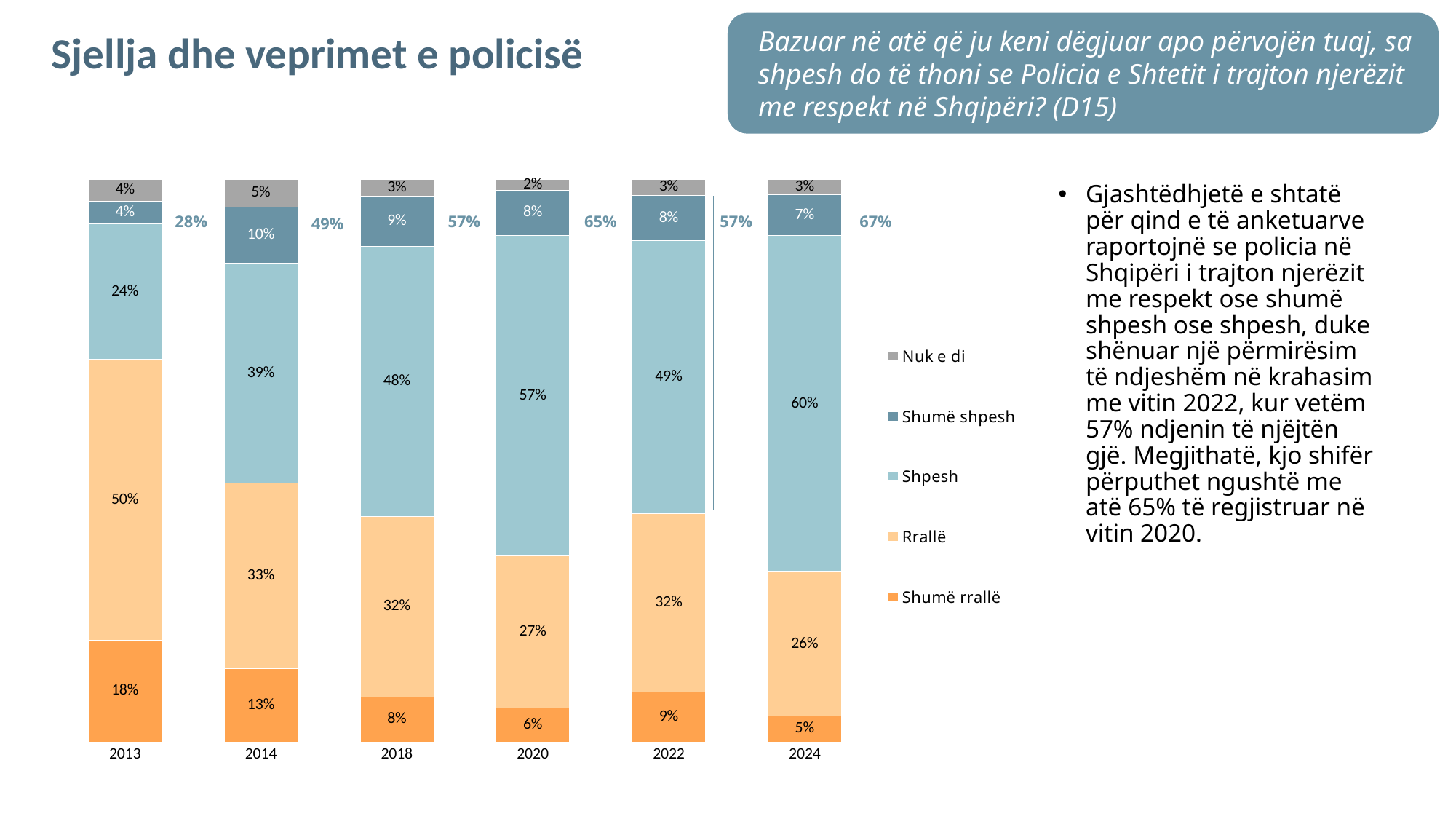
In which year is the 'Shumë rrallë' value lowest? 2024 What is the value for 'Rrallë' in 2020? 27% What is the value for 'Shpesh' in 2024? 60% How many series does the legend list? 5 Which is larger, the 'Shumë shpesh' value in 2014 or in 2022? 2014 What is the difference between the 'Rrallë' value in 2013 and in 2024? 24% What is the value for 'Shumë rrallë' in 2013? 18% In which year is the 'Shpesh' value highest? 2024 Does the 'Shumë rrallë' value rise or fall from 2013 to 2024? Fall What is the combined total of 'Shpesh' and 'Shumë shpesh' shown beside the 2020 bar? 65% How many years are shown on the x axis of the chart? 6 What kind of chart is shown on the slide? Stacked bar chart